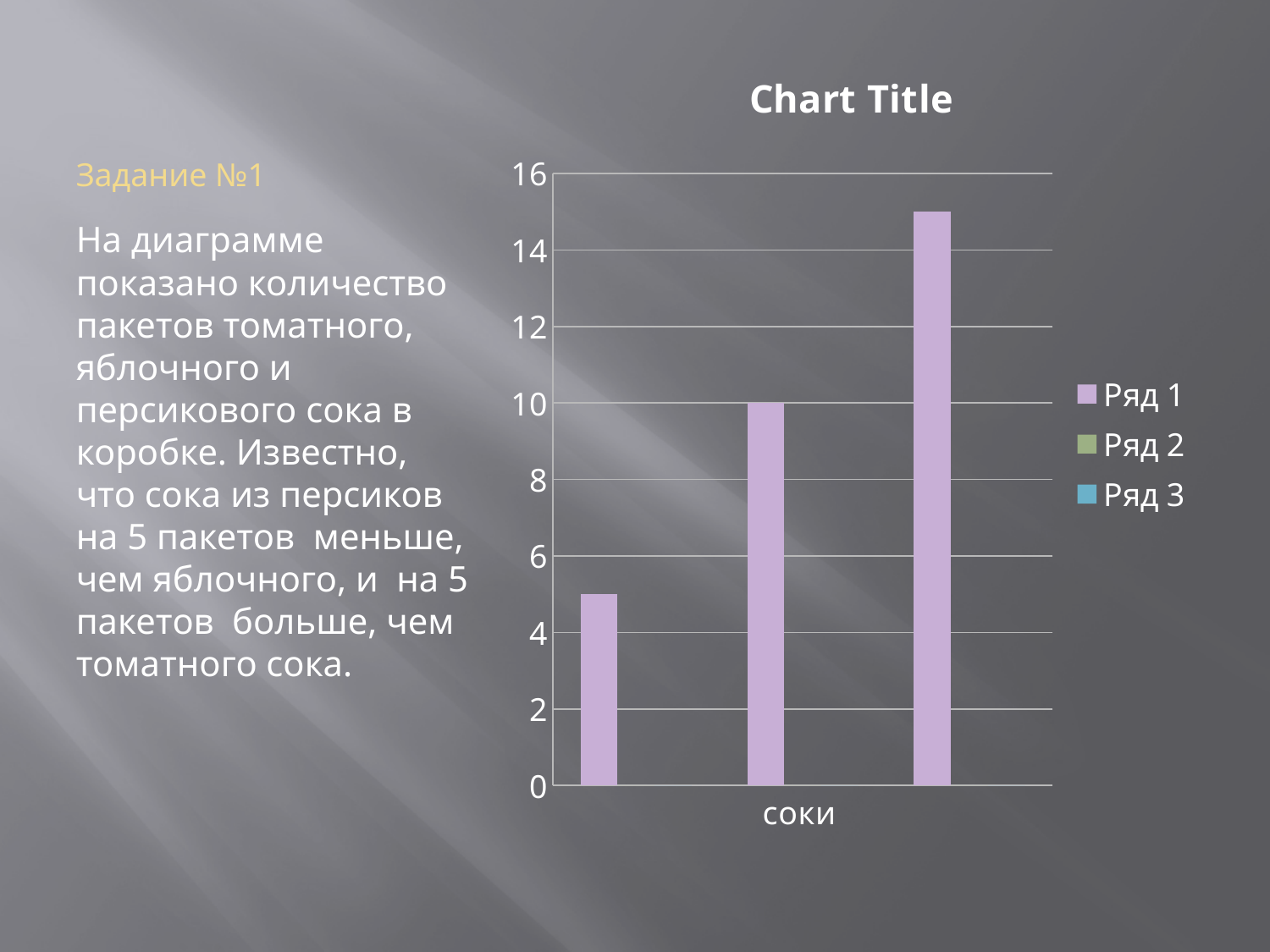
What is the category label shown on the x axis of the chart? соки What value does the middle bar in the chart reach? 10 What is the title of the chart? Chart Title How many bars are plotted in the chart? 3 What kind of chart is shown on the slide? bar chart Is the value of the leftmost bar in the chart greater or less than 6? less How many series does the chart legend list? 3 Is the value of the rightmost bar in the chart greater or less than 14? greater Which bar in the chart is the tallest: the leftmost, the middle or the rightmost? the rightmost What are the entries listed in the chart legend? Ряд 1, Ряд 2, Ряд 3 Do the bar values rise or fall from left to right across the chart? rise How many categories are labelled on the x axis of the chart? 1